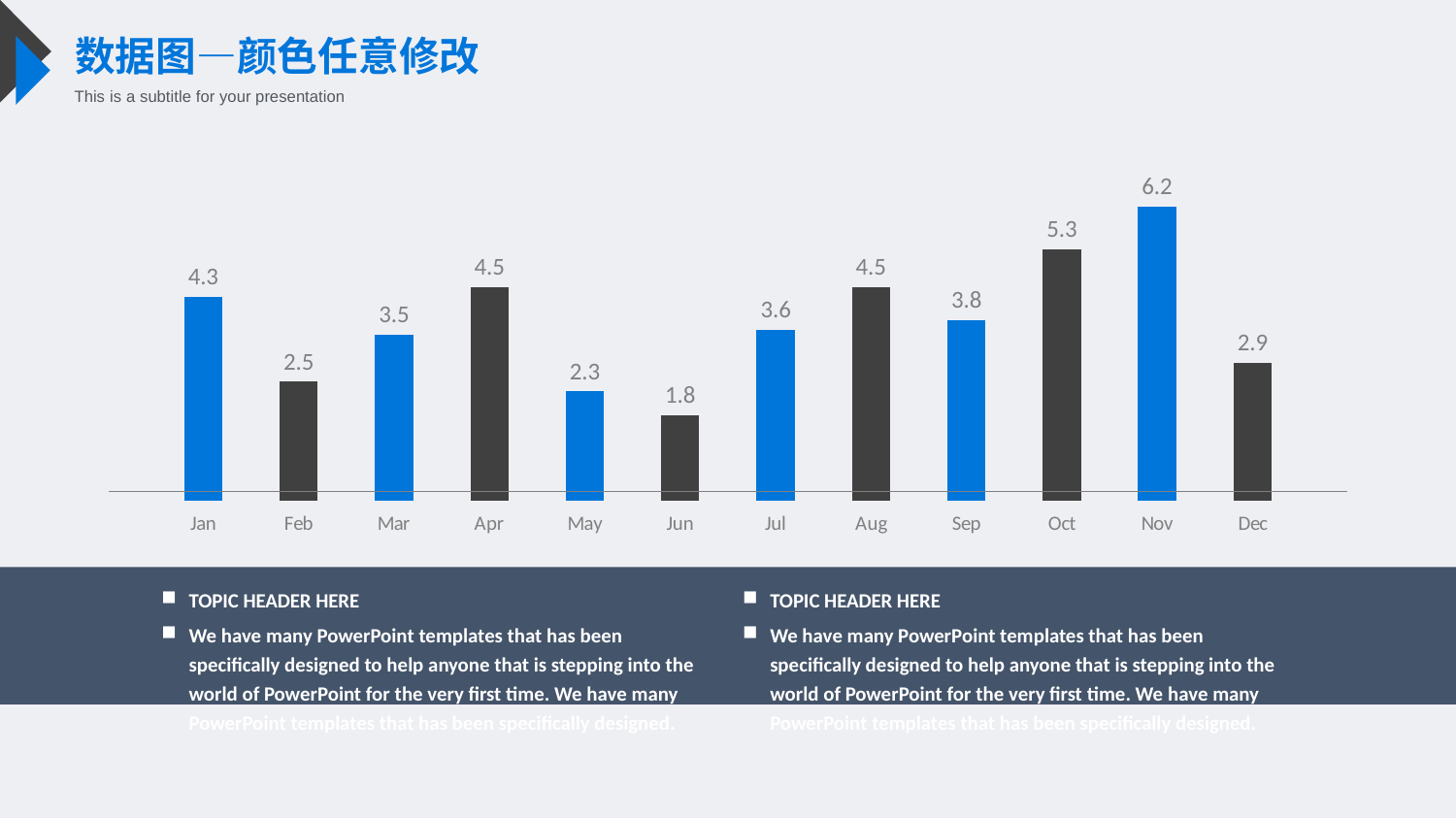
Which month has the lowest value? Jun Which is larger, the value for Feb or the value for Jul? Jul What is the value for Oct? 5.3 What colour is the bar for Nov? Blue Which is larger, the value for Mar or the value for Sep? Sep What is the value for Jan? 4.3 Which month has the highest value? Nov How many months are shown on the x axis? 12 What kind of chart is shown on the slide? Bar chart What is the difference between the values for Apr and May? 2.2 What is the difference between the values for Nov and Dec? 3.3 What is the value for Jun? 1.8